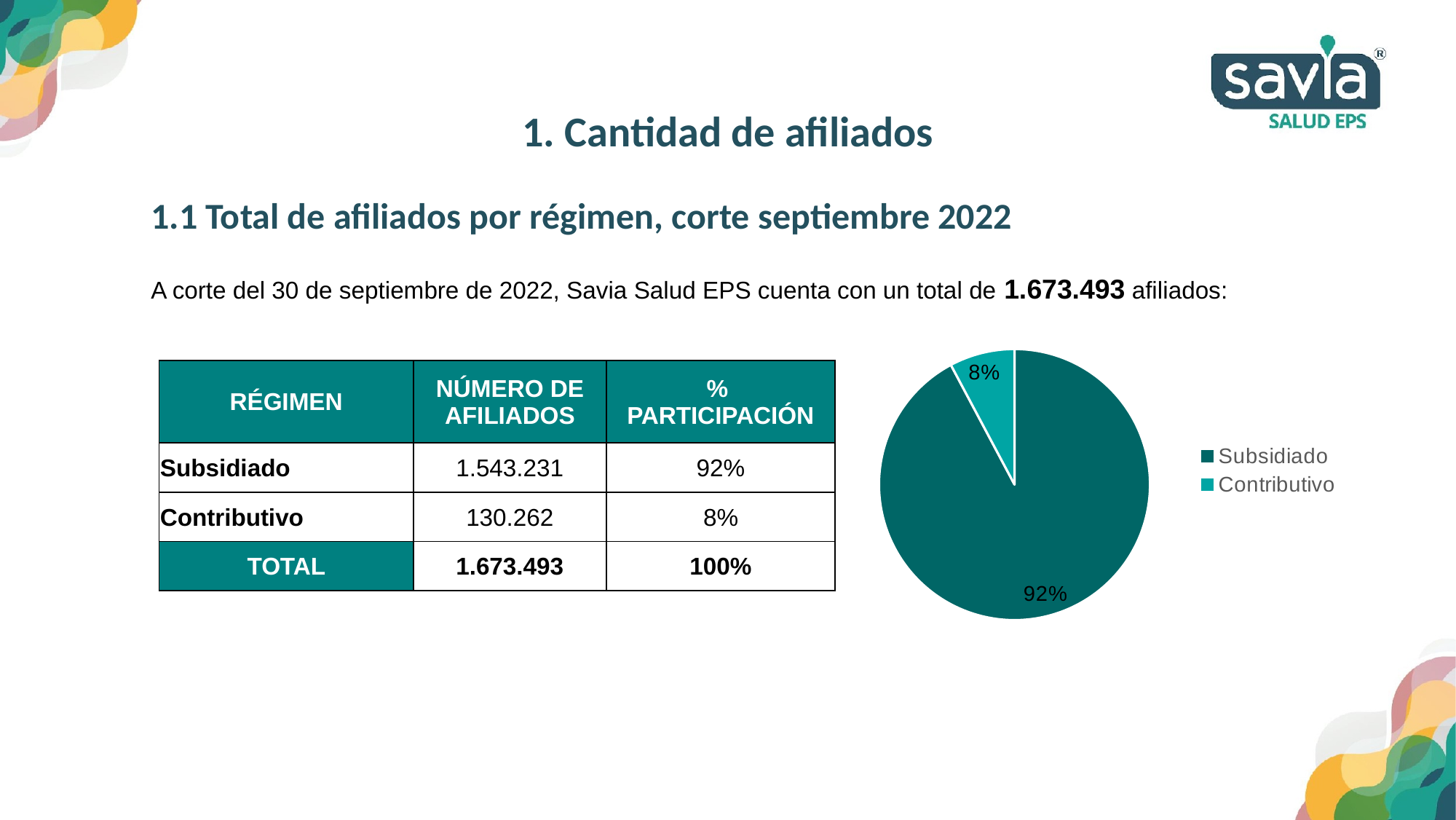
What share of the pie does Contributivo represent? 8% Which legend entry is listed first in the pie chart's legend? Subsidiado What is the difference in percentage points between the Subsidiado and Contributivo slices? 84 Which slice of the pie chart is the largest? Subsidiado What share of the pie does Subsidiado represent? 92% How many entries does the legend of the pie chart list? 2 What kind of chart is shown on the slide? pie chart Which legend entry is shown in the lighter teal colour? Contributivo Which is larger in the pie chart, Subsidiado or Contributivo? Subsidiado Which slice of the pie chart is the smallest? Contributivo How many slices does the pie chart have? 2